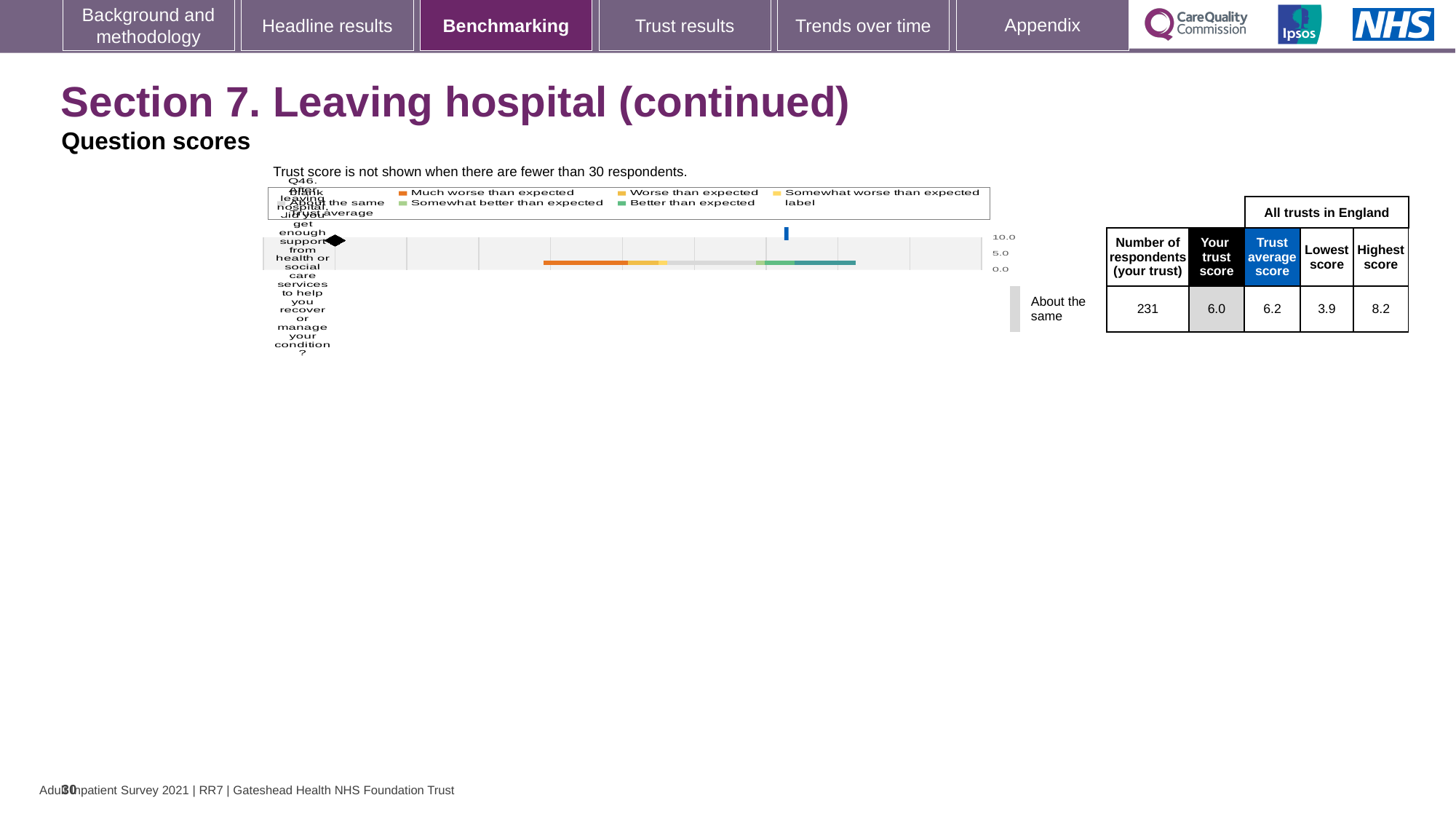
What is the lowest score among all trusts in England for Q46? 3.9 What is the difference between the trust average score and the trust's own score for Q46? 0.2 What is the trust average score across all trusts in England for Q46? 6.2 What is the difference between the highest and lowest scores for Q46 across all trusts in England? 4.3 How many respondents from the trust answered Q46? 231 What kind of chart is used to show the Q46 benchmarking result? Bar chart Which benchmark category is the trust's Q46 score placed in? About the same Is the trust score for Q46 greater or less than 5.0 on the chart's axis? greater What is the maximum value shown on the chart's score axis? 10.0 What is the trust score for Q46 (support from health or social care services after leaving hospital)? 6.0 What is the highest score among all trusts in England for Q46? 8.2 Which is larger for Q46: the trust's own score or the trust average score? Trust average score